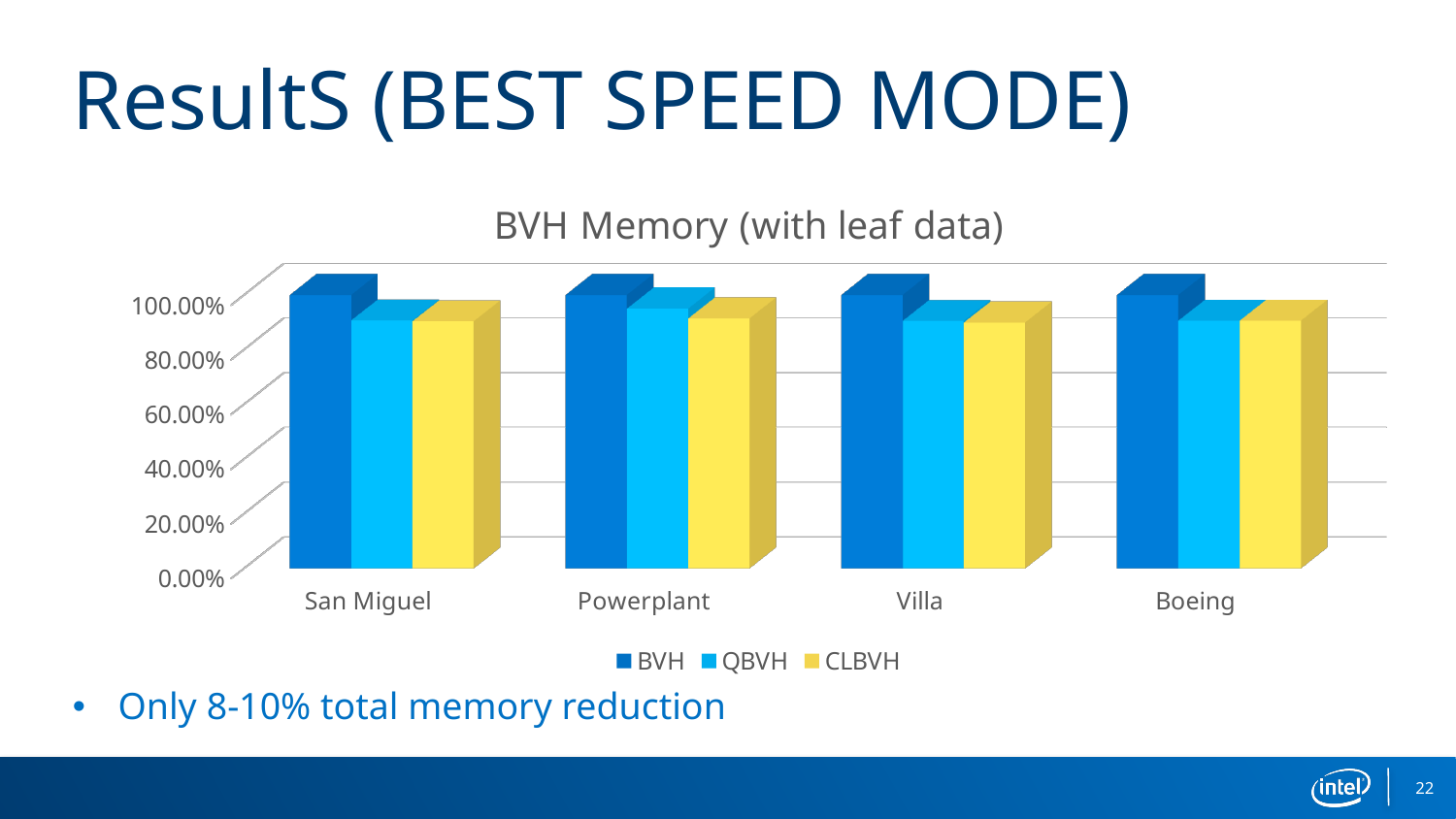
How many series does the legend list? 3 Which series are listed in the legend? BVH, QBVH, CLBVH How many scenes (categories) are shown on the x axis? 4 What is the title of the chart? BVH Memory (with leaf data) For Villa, which is larger: the BVH value or the QBVH value? BVH Which series has the highest value for San Miguel? BVH For Boeing, which is larger: the BVH value or the CLBVH value? BVH Is the value for QBVH in Powerplant greater or less than 80.00%? greater What kind of chart is shown on the slide? bar chart Is the value for CLBVH in Villa greater or less than 60.00%? greater Which series has the highest value for Boeing? BVH Is the value for QBVH in San Miguel greater or less than 80.00%? greater